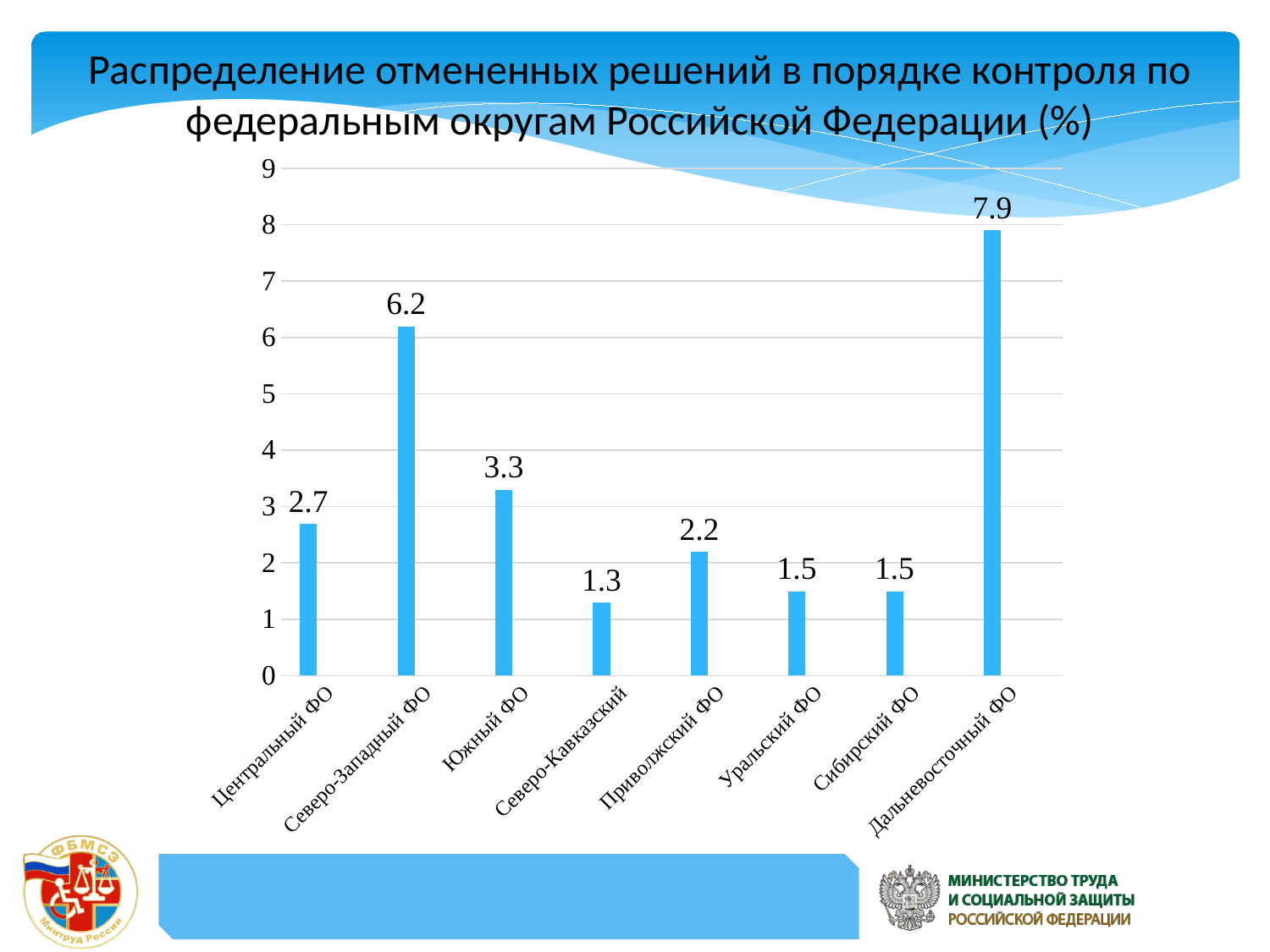
Which is larger, the value for Южный ФО or the value for Приволжский ФО? Южный ФО What kind of chart is shown on the slide? Bar chart How many federal districts are shown on the chart? 8 What is the difference between the values for Дальневосточный ФО and Северо-Западный ФО? 1.7 What is the title of the chart? Распределение отмененных решений в порядке контроля по федеральным округам Российской Федерации (%) What is the value for Приволжский ФО? 2.2 What is the value for Северо-Кавказский? 1.3 What is the value for Северо-Западный ФО? 6.2 Which federal district has the lowest value? Северо-Кавказский What is the difference between the values for Южный ФО and Центральный ФО? 0.6 Which federal district has the highest value? Дальневосточный ФО What is the value for Центральный ФО? 2.7